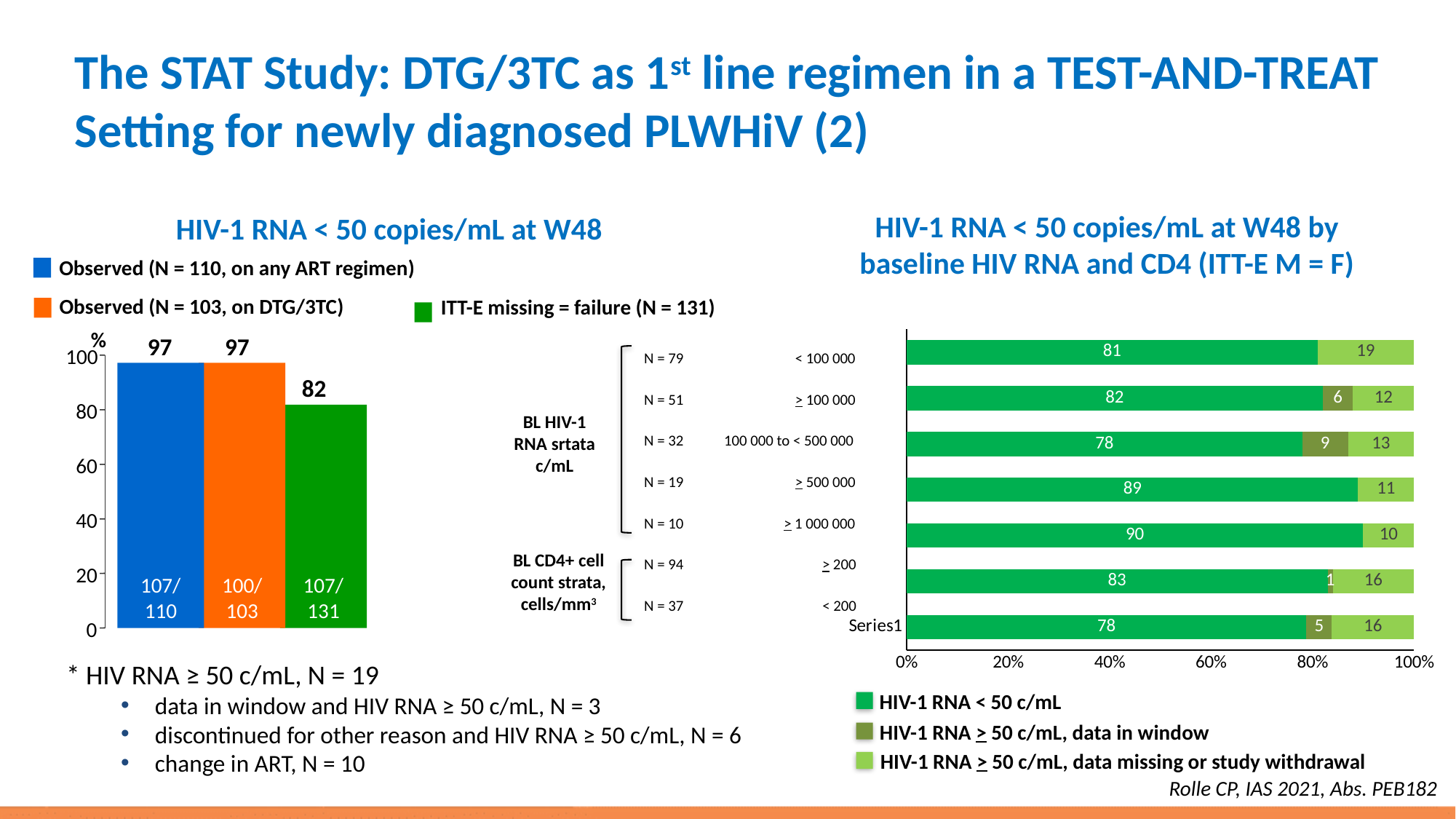
How many series does the legend of the right chart list? 3 In the right chart, which baseline stratum has the highest percentage with HIV-1 RNA < 50 c/mL? ≥ 1 000 000 c/mL (N = 10) How many bars are in the left chart 'HIV-1 RNA < 50 copies/mL at W48'? 3 In the left chart 'HIV-1 RNA < 50 copies/mL at W48', what percentage is shown for the ITT-E missing = failure (N = 131) bar? 82 In the right chart, is the HIV-1 RNA < 50 c/mL percentage larger for the CD4 ≥ 200 stratum (N = 94) or the CD4 < 200 stratum (N = 37)? CD4 ≥ 200 (N = 94) In the left chart 'HIV-1 RNA < 50 copies/mL at W48', which bar has the lowest value? ITT-E missing = failure (N = 131) In the left chart 'HIV-1 RNA < 50 copies/mL at W48', what fraction is printed inside the orange Observed (N = 103, on DTG/3TC) bar? 100/103 In the left chart 'HIV-1 RNA < 50 copies/mL at W48', what percentage is shown for the Observed (N = 110, on any ART regimen) bar? 97 In the right chart, what percentage had HIV-1 RNA < 50 c/mL in the baseline HIV-1 RNA ≥ 1 000 000 c/mL stratum (N = 10)? 90 In the left chart 'HIV-1 RNA < 50 copies/mL at W48', what is the difference between the Observed (N = 110) value and the ITT-E missing = failure value? 15 In the right chart, what percentage had HIV-1 RNA ≥ 50 c/mL with data in window in the 100 000 to < 500 000 c/mL stratum (N = 32)? 9 What type of chart is the right chart 'HIV-1 RNA < 50 copies/mL at W48 by baseline HIV RNA and CD4'? Stacked bar chart